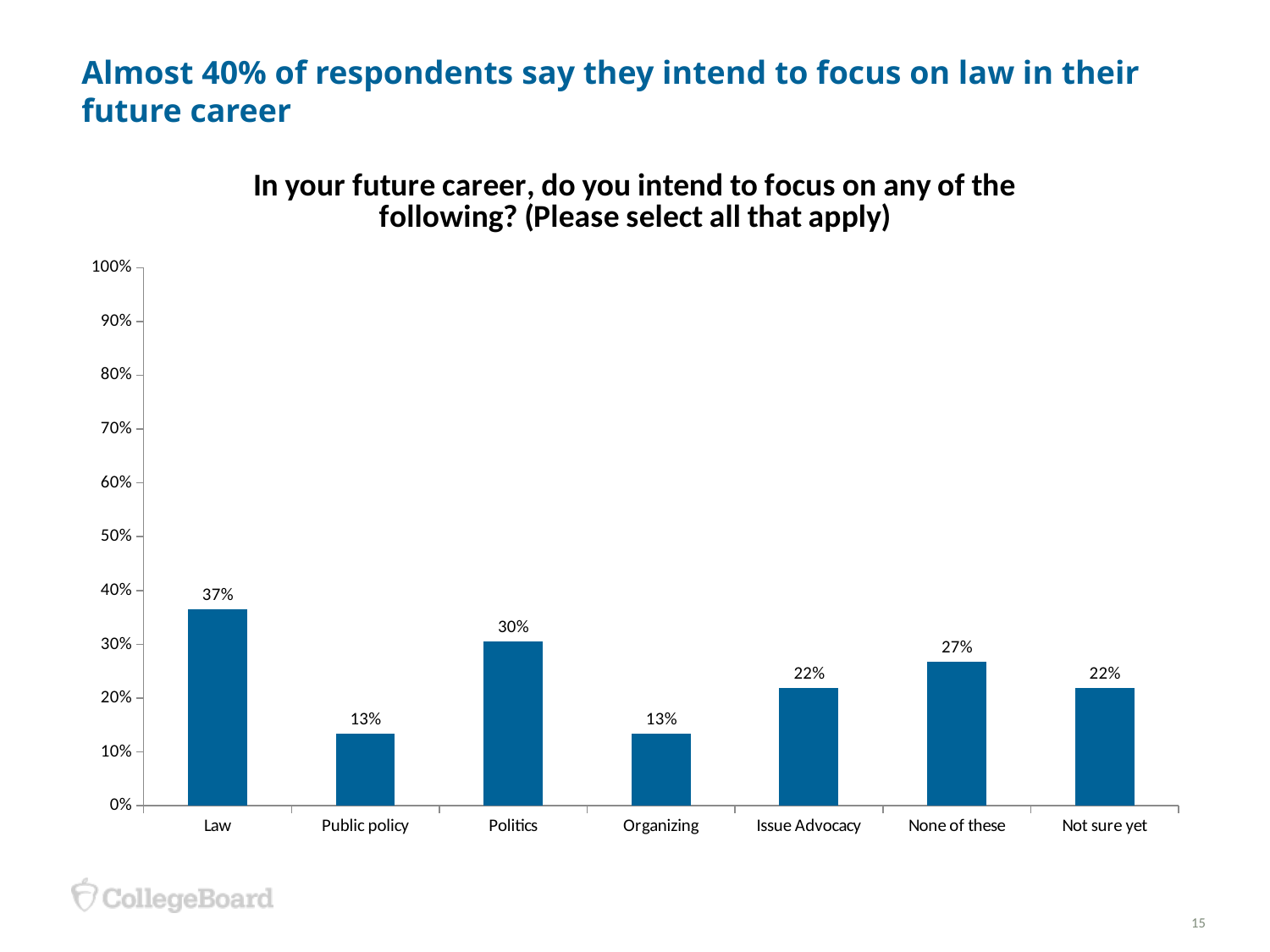
What is the value for Issue Advocacy? 22% What is the value shown for Politics? 30% Which is larger, the value for Politics or the value for None of these? Politics What is the title of the chart? In your future career, do you intend to focus on any of the following? (Please select all that apply) What kind of chart is shown on the slide? bar chart What percentage of respondents intend to focus on Law in their future career? 37% How many categories are shown on the x axis? 7 What percentage of respondents selected None of these? 27% Is the value for Law greater or less than 40%? less Which category has the highest value? Law What is the difference between the values for None of these and Public policy? 14% What is the difference between the values for Law and Politics? 7%